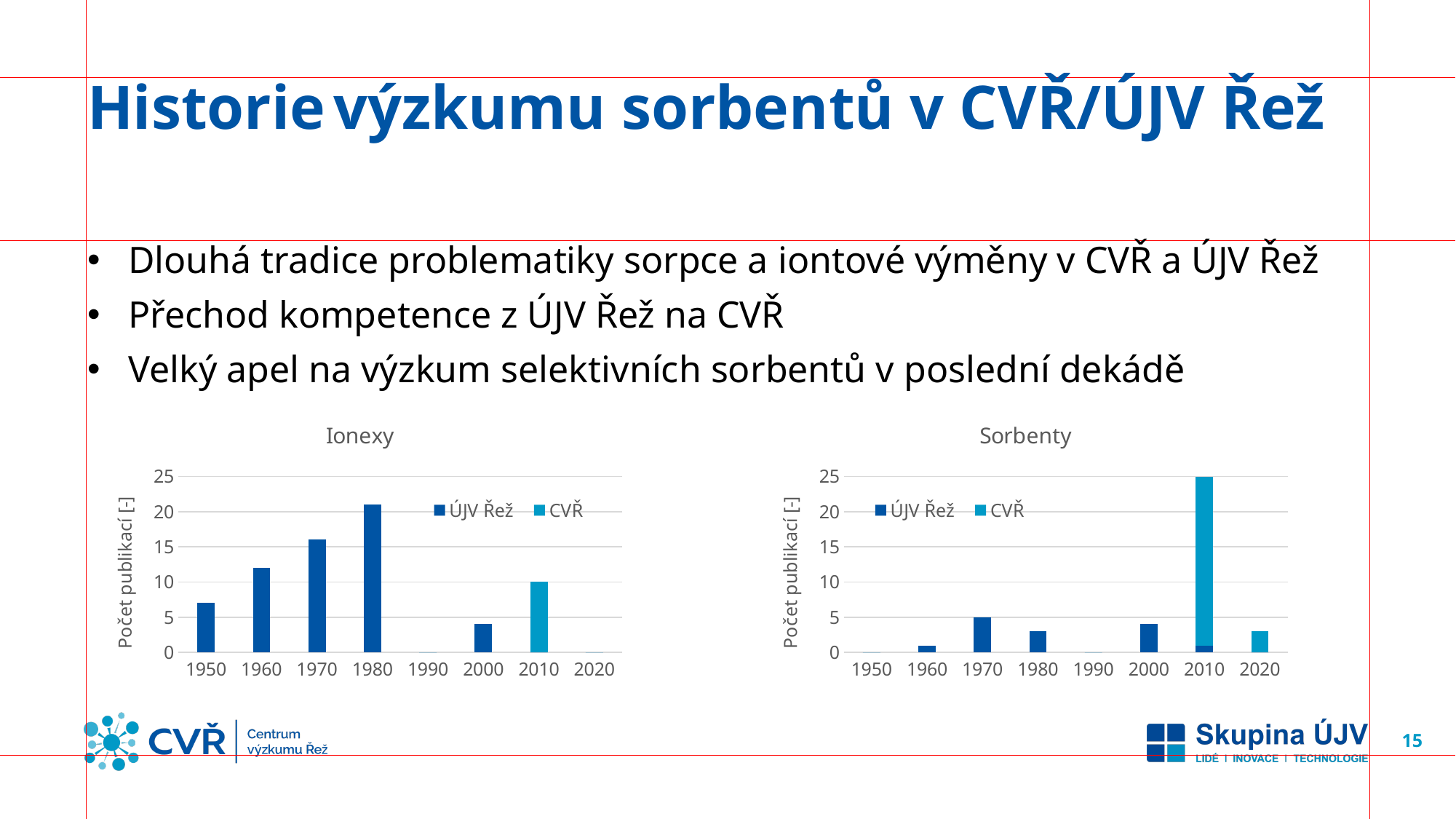
In the Ionexy chart, is the ÚJV Řež value for 2000 greater or less than 5? less In the Ionexy chart, which is larger: the ÚJV Řež bar for 1970 or the ÚJV Řež bar for 1960? 1970 In the Sorbenty chart, which year has the highest CVŘ bar? 2010 How many year categories are shown on the x axis of the Ionexy chart? 8 How many series does the legend of the Sorbenty chart list? 2 In the Ionexy chart, do the ÚJV Řež values rise or fall from 1950 to 1980? rise In the Ionexy chart, is the ÚJV Řež value for 1980 greater or less than 20? greater What are the titles of the two charts on the slide? Ionexy and Sorbenty What kind of chart is the Ionexy chart? bar chart What is the y-axis label of the Sorbenty chart? Počet publikací [-] In the Ionexy chart, which year has the highest ÚJV Řež bar? 1980 In the Sorbenty chart, is the CVŘ value for 2010 greater or less than 20? greater